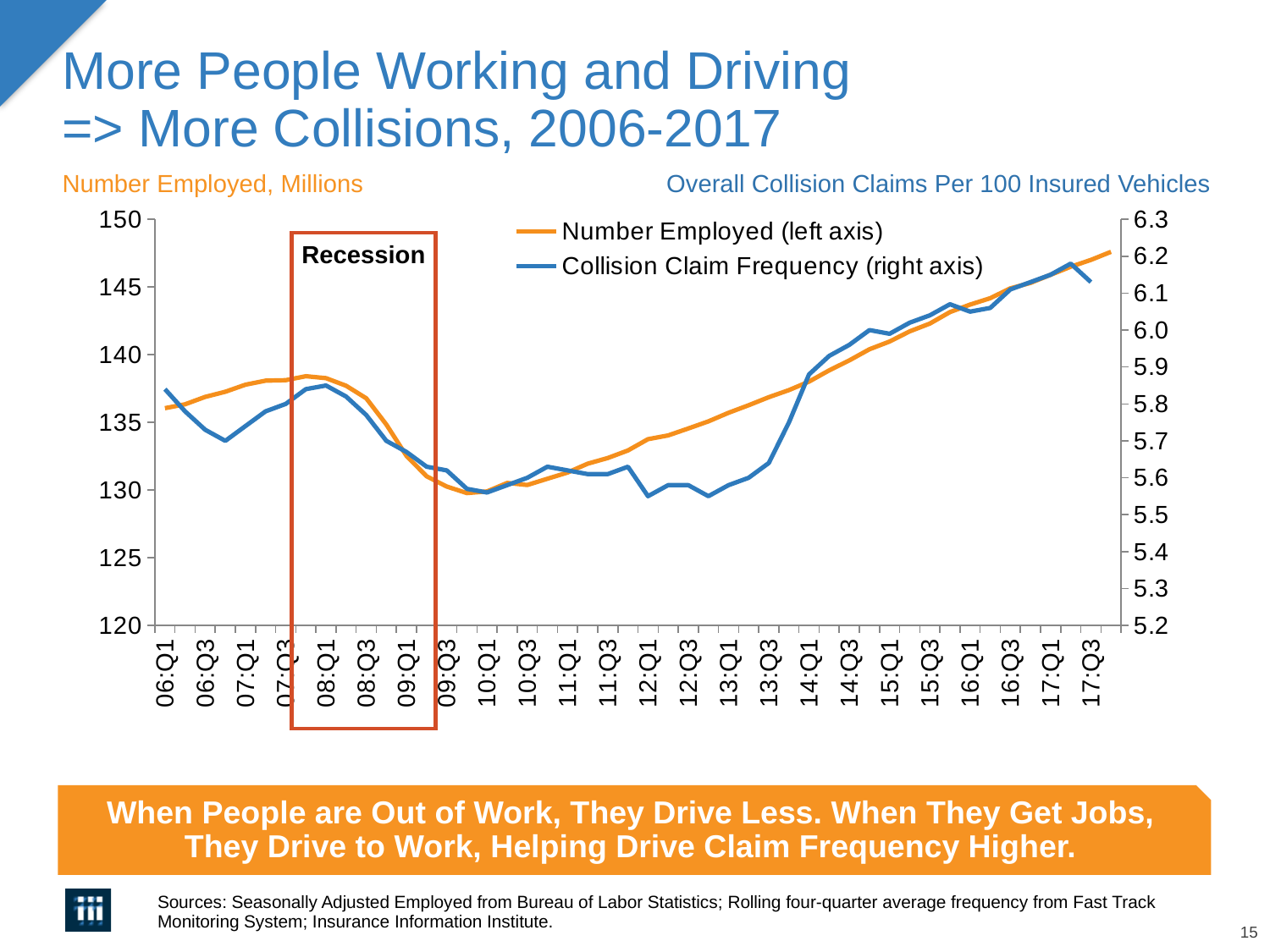
Does the Number Employed line rise or fall from 14:Q1 to 17:Q3? rise Is the value for Collision Claim Frequency at 17:Q1 greater or less than 6.0? greater Is the value for Collision Claim Frequency at 07:Q1 greater or less than 5.8? less Is the value for Number Employed at 10:Q1 greater or less than 135? less Does the Number Employed line rise or fall from 08:Q1 to 10:Q1? fall What kind of chart is shown on the slide? Line chart What is the label of the left vertical axis? Number Employed, Millions Which series is plotted against the right axis according to the legend? Collision Claim Frequency How many series does the chart's legend list? 2